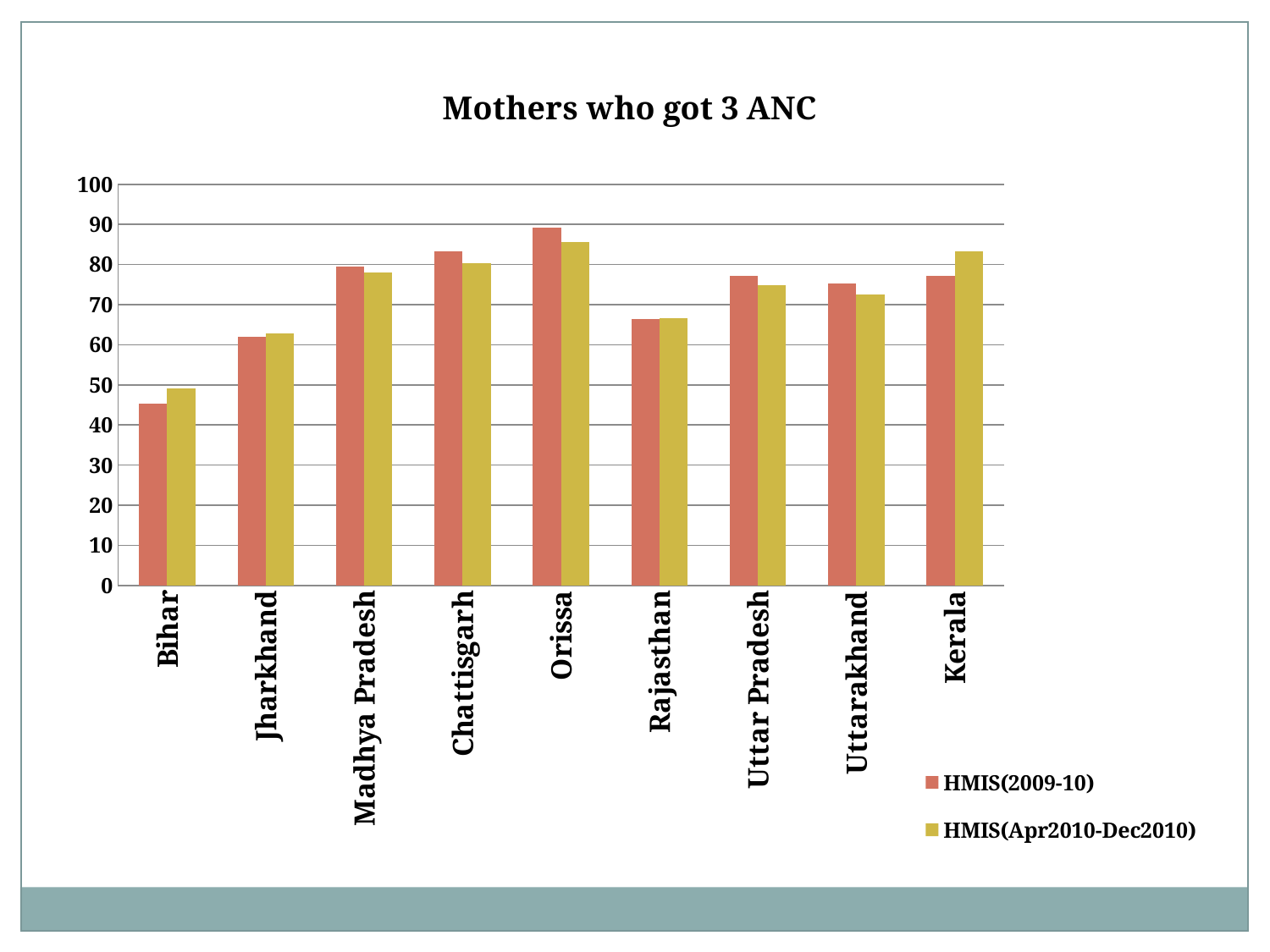
Is the HMIS(2009-10) value for Orissa greater or less than 80? greater Which state has the lowest HMIS(2009-10) value? Bihar For Orissa, which series has the larger value, HMIS(2009-10) or HMIS(Apr2010-Dec2010)? HMIS(2009-10) Which state has the highest HMIS(2009-10) value? Orissa For Kerala, which series has the larger value, HMIS(2009-10) or HMIS(Apr2010-Dec2010)? HMIS(Apr2010-Dec2010) What kind of chart is shown on the slide? Bar chart Which state has the lowest HMIS(Apr2010-Dec2010) value? Bihar Is the HMIS(2009-10) value for Bihar greater or less than 50? less How many states are shown on the x axis? 9 How many series does the legend list? 2 What is the title of the chart? Mothers who got 3 ANC Is the HMIS(Apr2010-Dec2010) value for Kerala greater or less than 80? greater